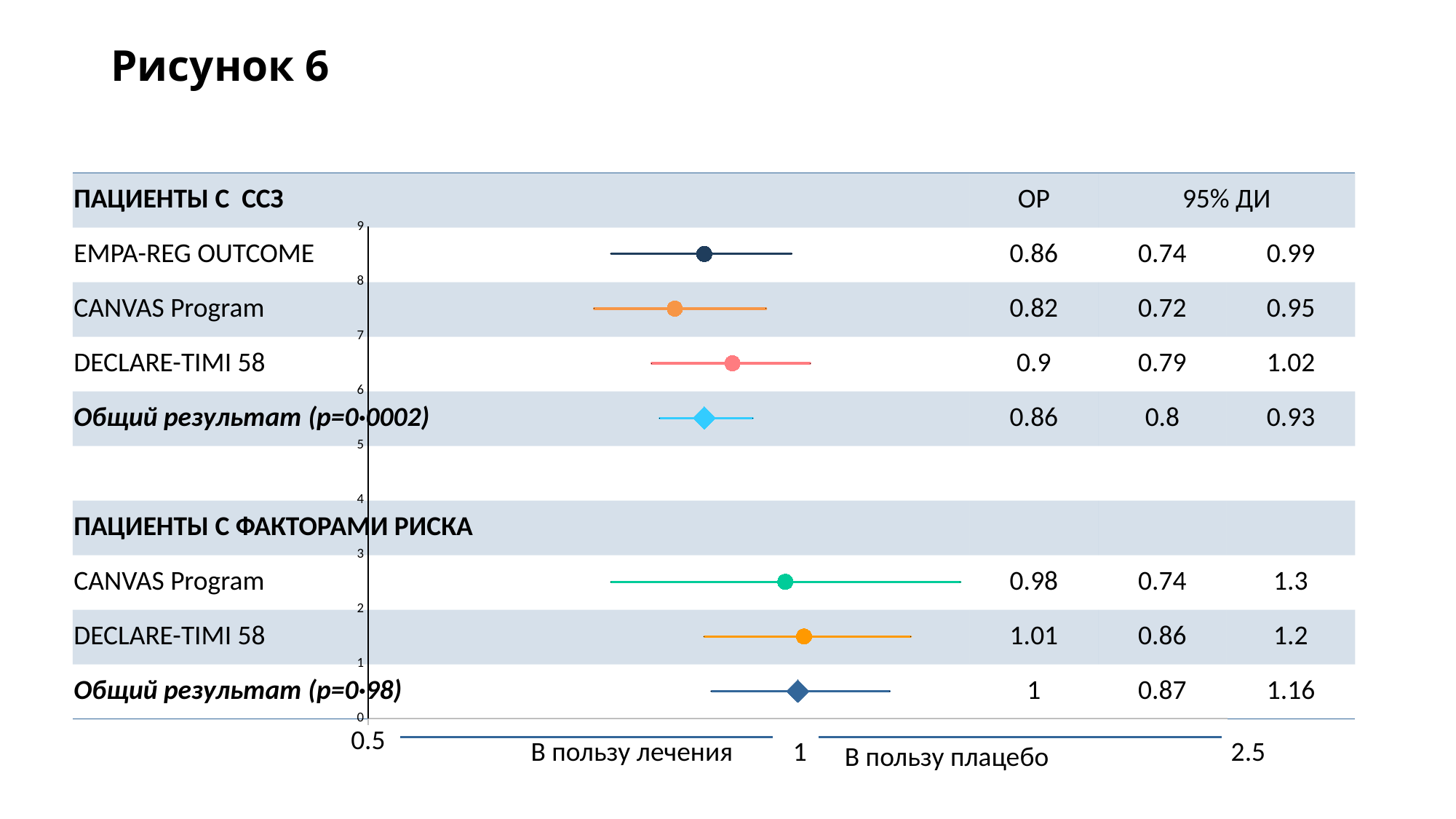
What label appears on the x axis to the left of 1, indicating the direction favouring treatment? В пользу лечения Which study has the highest OR (ОР) in the patients with risk factors (ПАЦИЕНТЫ С ФАКТОРАМИ РИСКА) group? DECLARE-TIMI 58 Which has a larger OR: DECLARE-TIMI 58 in the patients with CVD group or DECLARE-TIMI 58 in the patients with risk factors group? DECLARE-TIMI 58 in the patients with risk factors group What is the p-value shown for the overall result (Общий результат) in the patients with CVD group? p=0.0002 What is the OR (ОР) value for CANVAS Program in the patients with CVD (ПАЦИЕНТЫ С ССЗ) group? 0.82 What is the OR (ОР) value for the overall result (Общий результат) in the patients with risk factors (ПАЦИЕНТЫ С ФАКТОРАМИ РИСКА) group? 1 Which study has the lowest OR (ОР) in the patients with CVD (ПАЦИЕНТЫ С ССЗ) group? CANVAS Program What is the lower bound of the 95% CI for CANVAS Program in the patients with risk factors group? 0.74 What is the OR (ОР) value for EMPA-REG OUTCOME in the patients with CVD (ПАЦИЕНТЫ С ССЗ) group? 0.86 How many individual studies (excluding overall results) are plotted in the patients with CVD (ПАЦИЕНТЫ С ССЗ) group? 3 What is the difference between the OR for DECLARE-TIMI 58 and the OR for CANVAS Program in the patients with CVD group? 0.08 What is the upper bound of the 95% CI (95% ДИ) for DECLARE-TIMI 58 in the patients with CVD group? 1.02